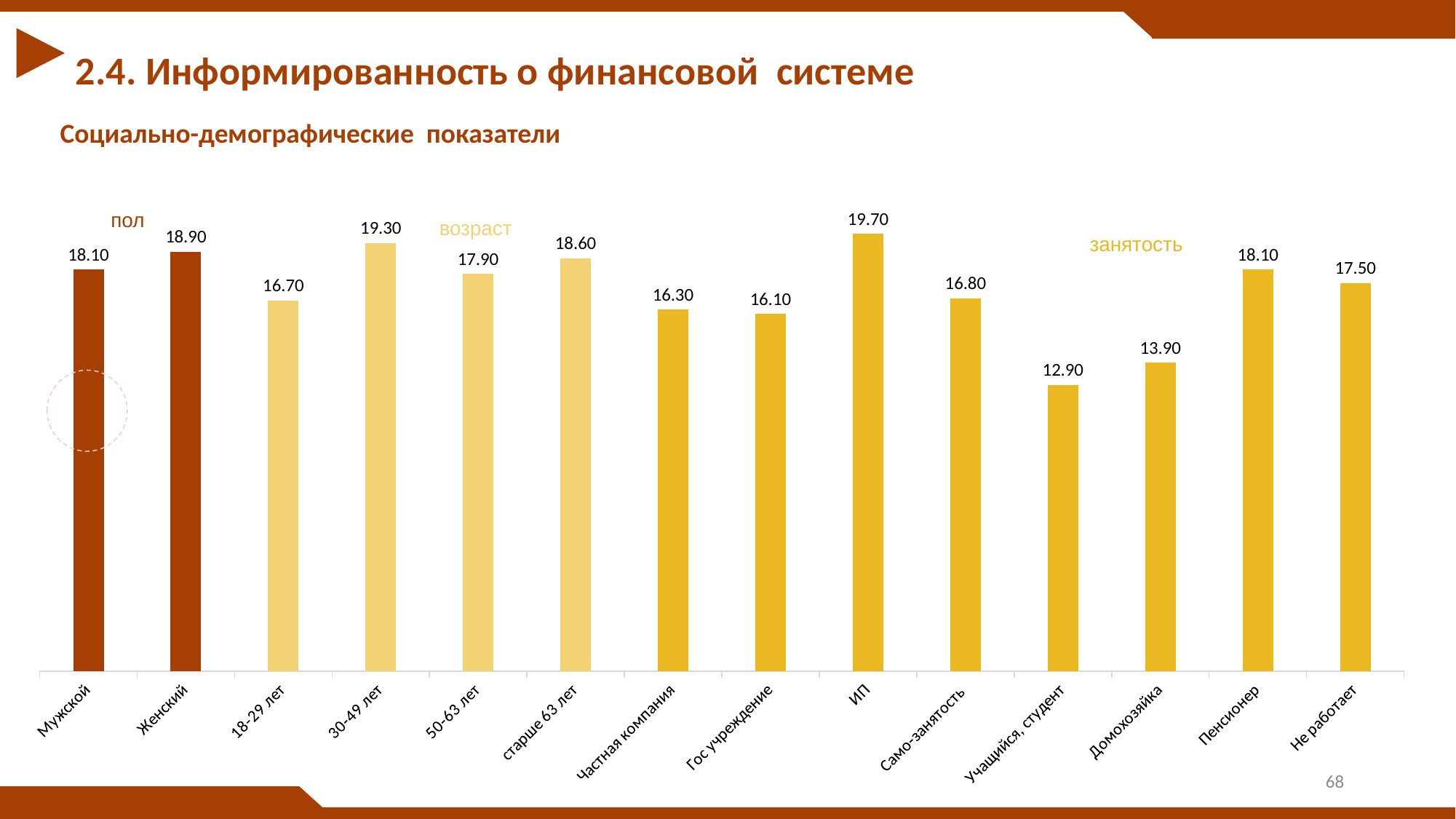
How many categories are shown on the chart? 14 What are the three group labels shown above the bars? пол, возраст, занятость Which category has the highest value? ИП What is the value for Домохозяйка? 13.90 What is the difference between the values for Женский and Мужской? 0.80 What is the difference between the values for ИП and Учащийся, студент? 6.80 What is the value for Гос учреждение? 16.10 What is the value for 30-49 лет? 19.30 What is the value for Женский? 18.90 What kind of chart is shown on the slide? Bar chart Which category has the lowest value? Учащийся, студент Which is larger, the value for 18-29 лет or the value for старше 63 лет? старше 63 лет